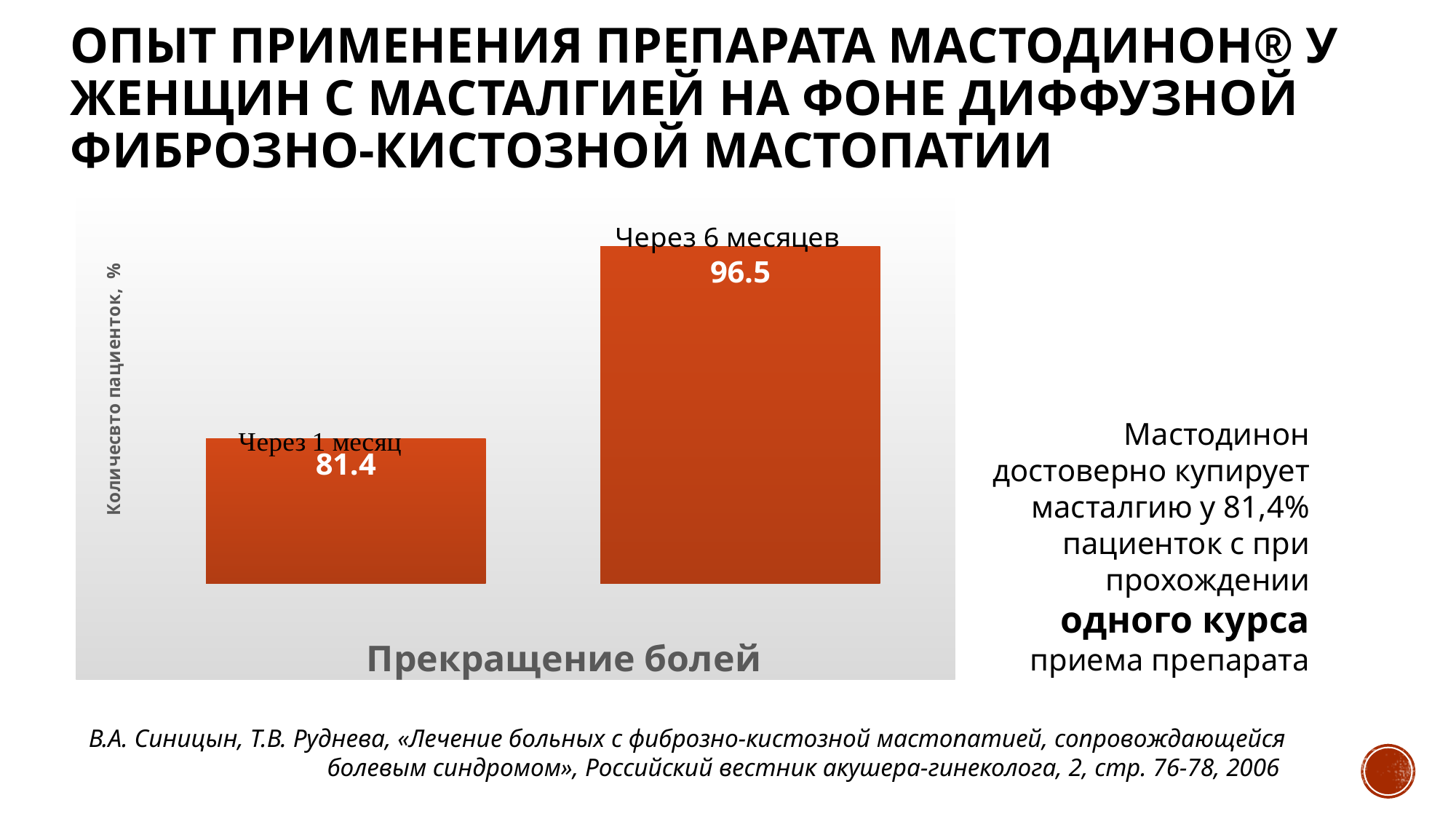
What is the difference between the values for "Через 6 месяцев" and "Через 1 месяц"? 15.1 Which is larger, the value for "Через 1 месяц" or the value for "Через 6 месяцев"? Через 6 месяцев What is the value for "Через 6 месяцев"? 96.5 How many bars are plotted in the chart? 2 Which bar has the highest value? Через 6 месяцев What is the value for "Через 1 месяц"? 81.4 Which bar has the lowest value? Через 1 месяц What type of chart is shown on the slide? bar chart What is the category label shown at the bottom of the chart? Прекращение болей What is the label on the vertical axis of the chart? Количесвто пациенток, % Do the values rise or fall from "Через 1 месяц" to "Через 6 месяцев"? rise